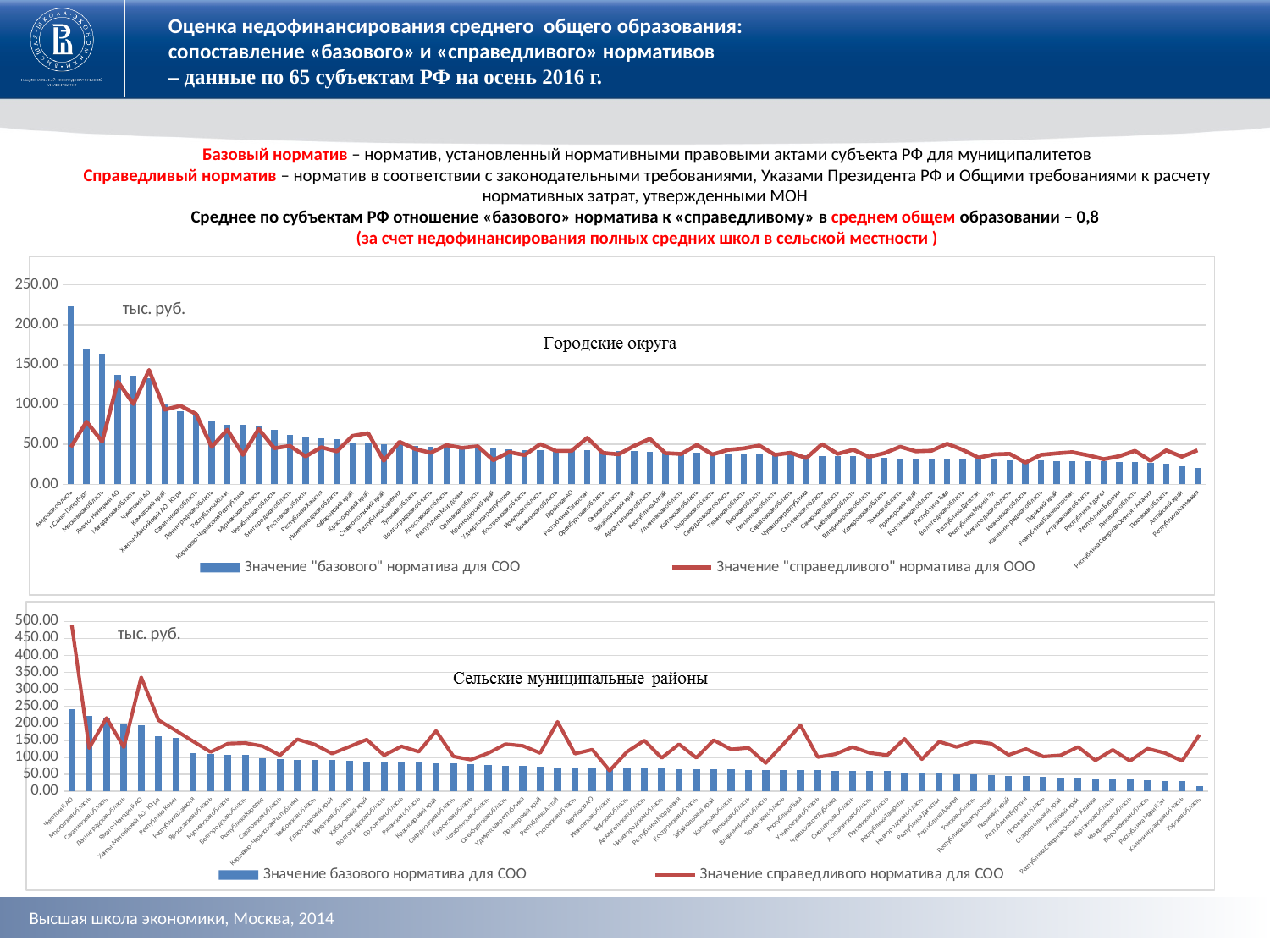
What kind of chart is the top chart titled "Городские округа"? A bar chart with a line series In the top chart ("Городские округа"), which is larger: the leftmost blue bar or the second blue bar from the left? The leftmost blue bar In the top chart ("Городские округа"), is the value of the leftmost blue bar greater or less than 200? greater What does the legend of the top chart ("Городские округа") say the red line represents? Значение "справедливого" норматива для ООО How many series does the legend of the top chart ("Городские округа") list? 2 How many series does the legend of the bottom chart ("Сельские муниципальные районы") list? 2 In the bottom chart ("Сельские муниципальные районы"), is the value of the leftmost red line point greater or less than 400? greater In the bottom chart ("Сельские муниципальные районы"), do the blue bar values rise or fall from left to right along the x axis? Fall In the bottom chart ("Сельские муниципальные районы"), is the value of the rightmost blue bar greater or less than 50? less In the top chart ("Городские округа"), do the blue bar values rise or fall from left to right along the x axis? Fall What is the highest value shown on the y axis of the bottom chart ("Сельские муниципальные районы")? 500.00